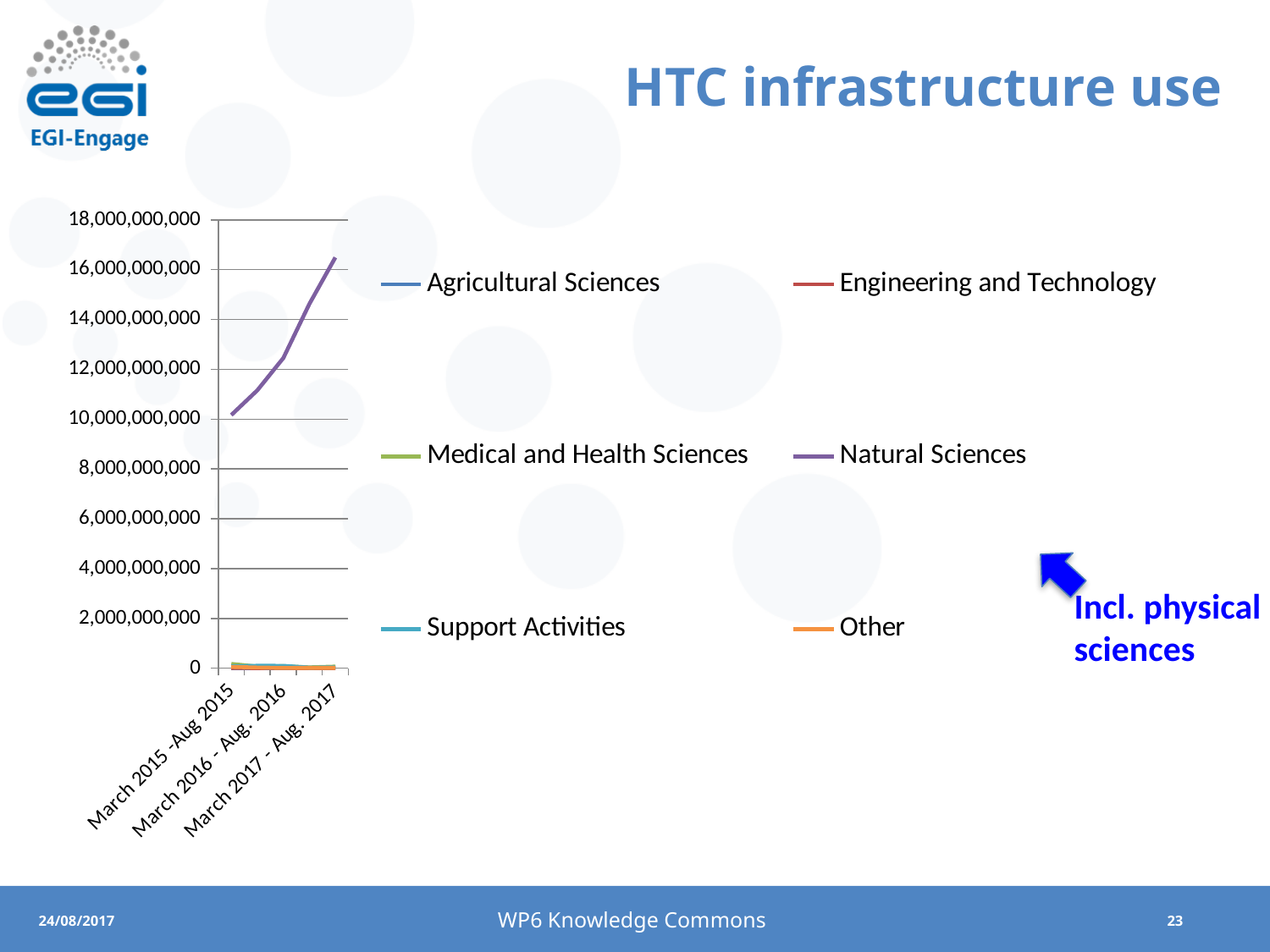
What is the title of the slide containing the chart? HTC infrastructure use How many time periods are shown on the x axis of the chart? 3 Is the value for Natural Sciences in March 2015 - Aug 2015 greater or less than 8,000,000,000? greater Which series has the highest values in the chart? Natural Sciences How many series does the chart legend list? 6 Is the value for Natural Sciences in March 2017 - Aug. 2017 greater or less than 14,000,000,000? greater Is the value for Natural Sciences in March 2016 - Aug. 2016 greater or less than 14,000,000,000? less Which is larger in March 2017 - Aug. 2017: Natural Sciences or Other? Natural Sciences Does the Natural Sciences line rise or fall from March 2015 - Aug 2015 to March 2017 - Aug. 2017? rise What kind of chart is shown on the slide? line chart According to the annotation next to the chart, what does the Natural Sciences series include? Incl. physical sciences